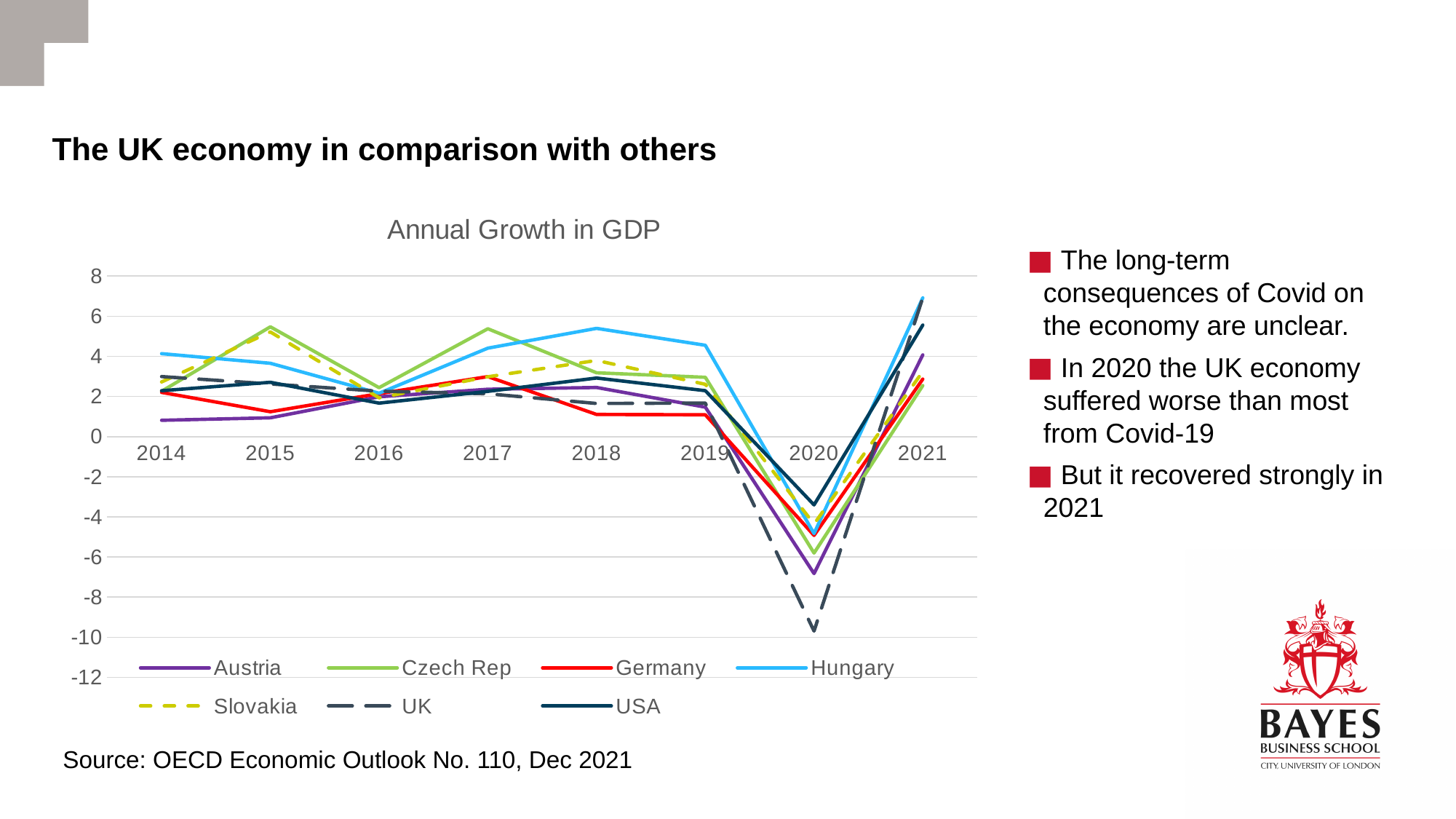
Is the value for Austria in 2014 greater or less than 2? less Which country had the highest annual GDP growth in 2020? USA Which country had the lowest annual GDP growth in 2020? UK How many series does the chart's legend list? 7 What is the title of the chart? Annual Growth in GDP Did the UK's annual GDP growth rise or fall between 2019 and 2020? fall Is the value for Hungary in 2018 greater or less than 4? greater How many years are shown along the x axis of the chart? 8 Which two series are drawn with dashed lines in the chart? Slovakia and UK Is the value for the UK in 2020 greater or less than -8? less What kind of chart is shown on the slide? line chart In 2020, which had the larger annual GDP growth, Austria or Germany? Germany